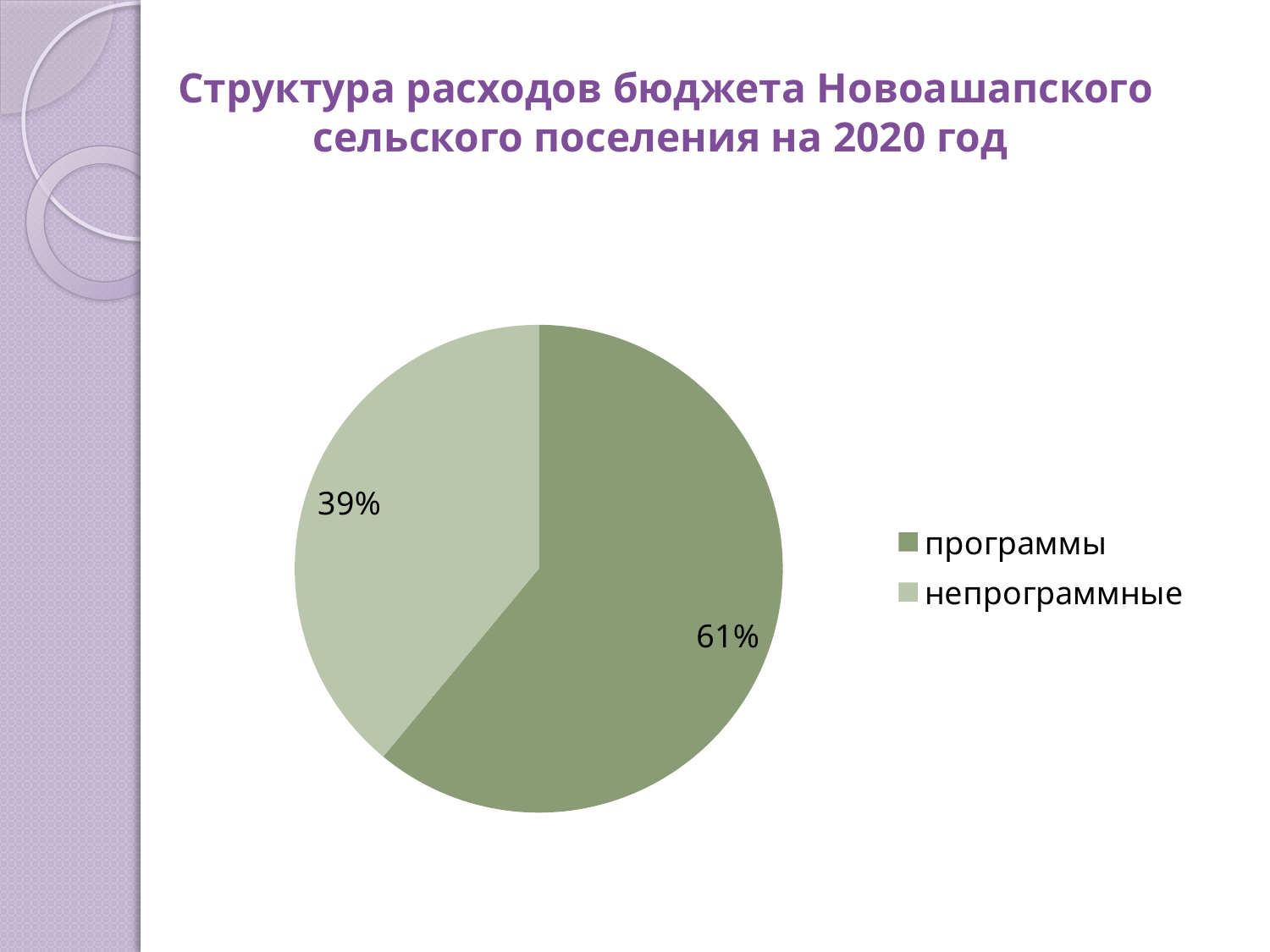
What kind of chart is shown on the slide? pie chart What is the title of the slide containing the chart? Структура расходов бюджета Новоашапского сельского поселения на 2020 год How many slices does the pie chart have? 2 How many entries does the legend list? 2 Which legend entry is shown with the darker green colour? программы Which is larger, the "программы" slice or the "непрограммные" slice? программы What share of the pie does the "непрограммные" slice represent? 39% Which category has the smallest slice of the pie? непрограммные What is the difference in percentage points between the "программы" and "непрограммные" slices? 22 What share of the pie does the "программы" slice represent? 61% Which category has the largest slice of the pie? программы